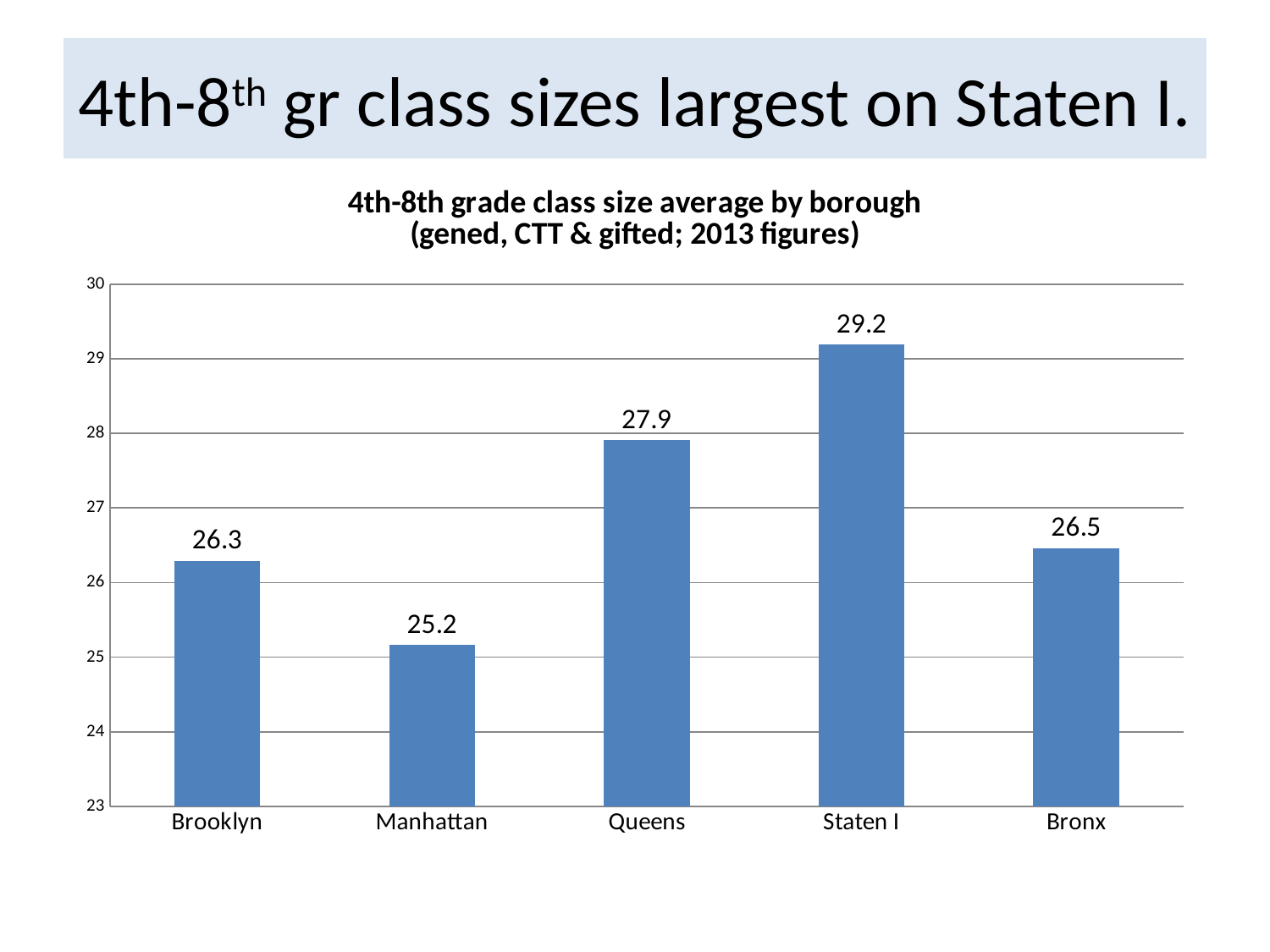
What is the difference between the average class size for Queens and Brooklyn? 1.6 What kind of chart is shown on the slide? bar chart How many boroughs are shown on the chart? 5 What is the average 4th-8th grade class size for the Bronx? 26.5 Is the average class size for Queens greater or less than 28? less Which borough has the largest average 4th-8th grade class size? Staten I What is the average 4th-8th grade class size for Queens? 27.9 What is the average 4th-8th grade class size for Manhattan? 25.2 Which borough has the smallest average 4th-8th grade class size? Manhattan What is the average 4th-8th grade class size for Brooklyn? 26.3 What is the difference between the average class size for Staten I and Manhattan? 4.0 Which borough has a larger average class size, Brooklyn or the Bronx? Bronx